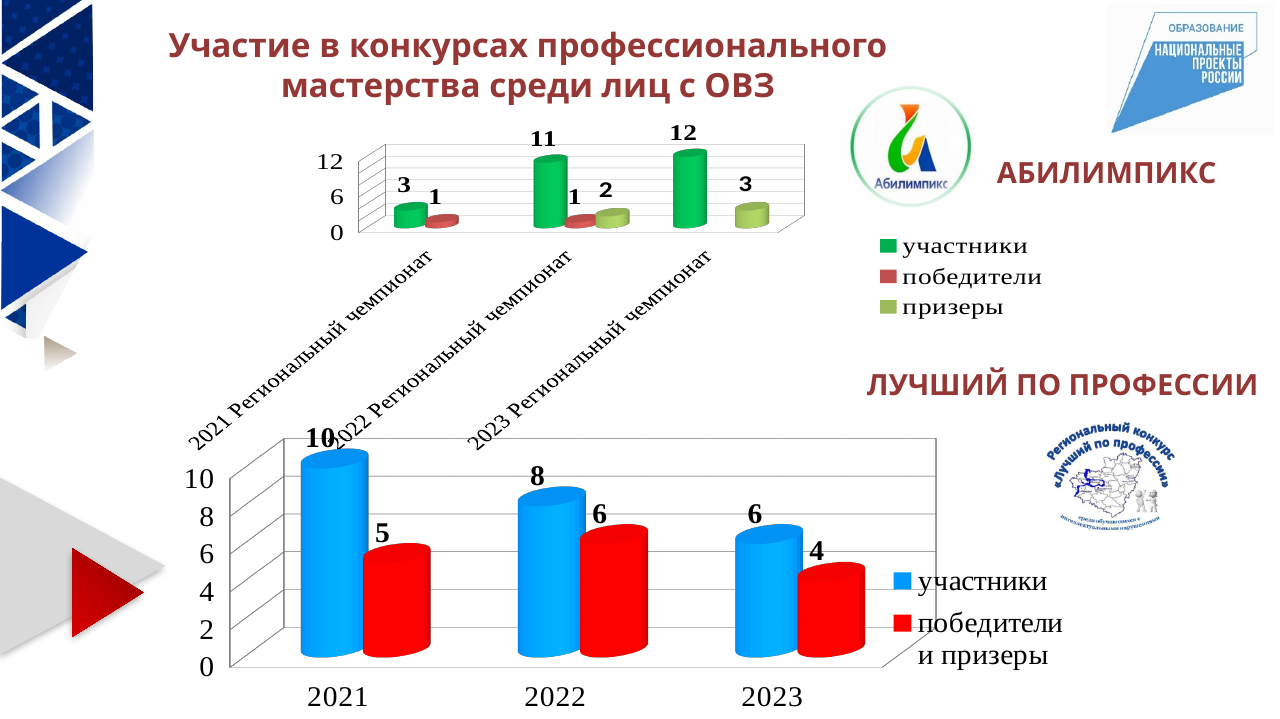
In the Лучший по профессии chart (bottom), is the value for победители и призеры larger in 2022 or in 2023? 2022 What kind of chart is the Лучший по профессии chart (bottom)? bar chart In the Лучший по профессии chart (bottom), what is the difference between участники and победители и призеры in 2021? 5 In the Лучший по профессии chart (bottom), which year has the lowest number of участники? 2023 In the Лучший по профессии chart (bottom), do the values for участники rise or fall from 2021 to 2023? fall In the Абилимпикс chart (top), what is the difference in участники between the 2022 and 2021 Региональный чемпионат? 8 In the Абилимпикс chart (top), what is the value for призеры in the 2022 Региональный чемпионат? 2 In the Абилимпикс chart (top), which championship has the highest number of участники? 2023 Региональный чемпионат In the Абилимпикс chart (top), how many series does the legend list? 3 In the Лучший по профессии chart (bottom), what is the value for победители и призеры in 2023? 4 In the Лучший по профессии chart (bottom), what is the value for участники in 2021? 10 In the Абилимпикс chart (top), what is the value for участники in the 2023 Региональный чемпионат? 12